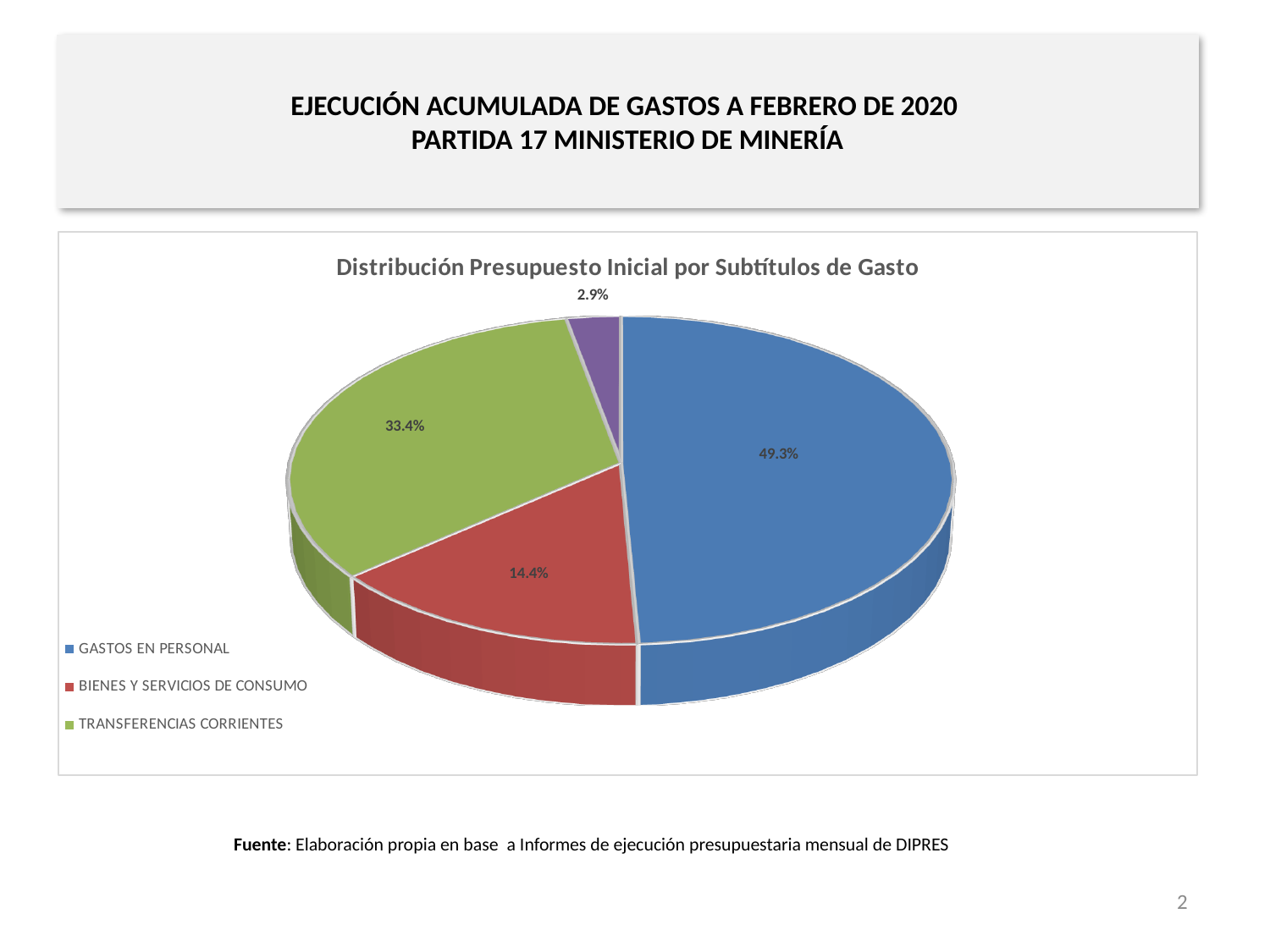
Which category has the largest slice of the pie? GASTOS EN PERSONAL What share of the pie does TRANSFERENCIAS CORRIENTES represent? 33.4% What share of the pie does BIENES Y SERVICIOS DE CONSUMO represent? 14.4% How many slices does the pie chart have? 4 What is the difference in percentage points between TRANSFERENCIAS CORRIENTES and BIENES Y SERVICIOS DE CONSUMO? 19.0 What kind of chart is shown on the slide? pie chart What share of the pie does GASTOS EN PERSONAL represent? 49.3% What is the smallest percentage shown on the pie chart? 2.9% What is the difference in percentage points between GASTOS EN PERSONAL and TRANSFERENCIAS CORRIENTES? 15.9 Which is larger, the share for TRANSFERENCIAS CORRIENTES or the share for BIENES Y SERVICIOS DE CONSUMO? TRANSFERENCIAS CORRIENTES How many entries does the legend list? 3 What is the title of the chart? Distribución Presupuesto Inicial por Subtítulos de Gasto